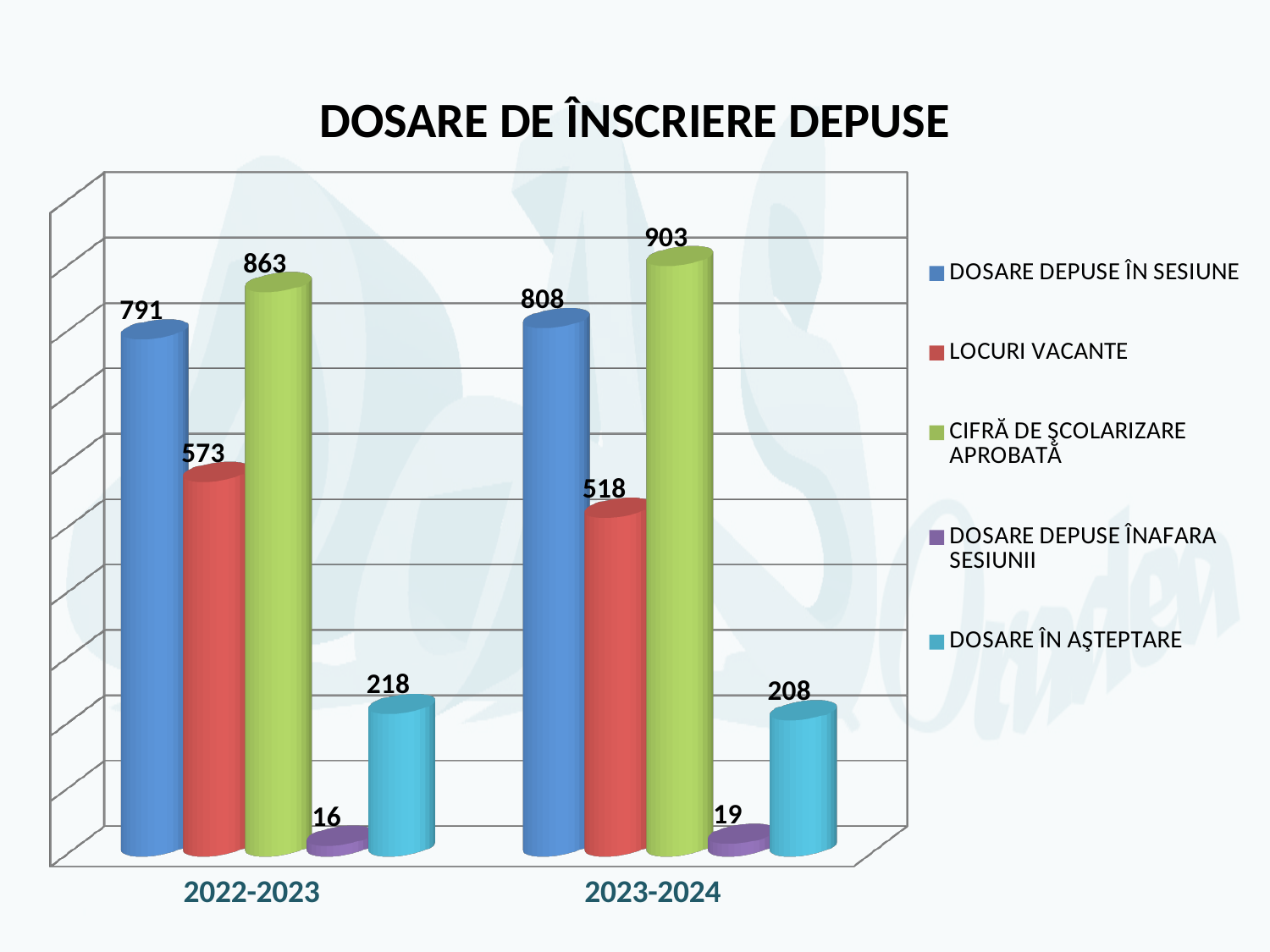
What kind of chart is shown on the slide? Bar chart What is the difference between CIFRĂ DE ȘCOLARIZARE APROBATĂ and DOSARE DEPUSE ÎN SESIUNE in 2023-2024? 95 What is the title of the chart? DOSARE DE ÎNSCRIERE DEPUSE What is the value for DOSARE DEPUSE ÎNAFARA SESIUNII in 2022-2023? 16 What is the value for DOSARE DEPUSE ÎN SESIUNE in 2022-2023? 791 How many series does the legend list? 5 Which is larger: DOSARE ÎN AȘTEPTARE in 2022-2023 or in 2023-2024? 2022-2023 What is the difference in LOCURI VACANTE between 2022-2023 and 2023-2024? 55 Which series has the highest value in 2023-2024? CIFRĂ DE ȘCOLARIZARE APROBATĂ What is the value for CIFRĂ DE ȘCOLARIZARE APROBATĂ in 2023-2024? 903 What is the value for LOCURI VACANTE in 2023-2024? 518 Which series has the lowest value in 2022-2023? DOSARE DEPUSE ÎNAFARA SESIUNII